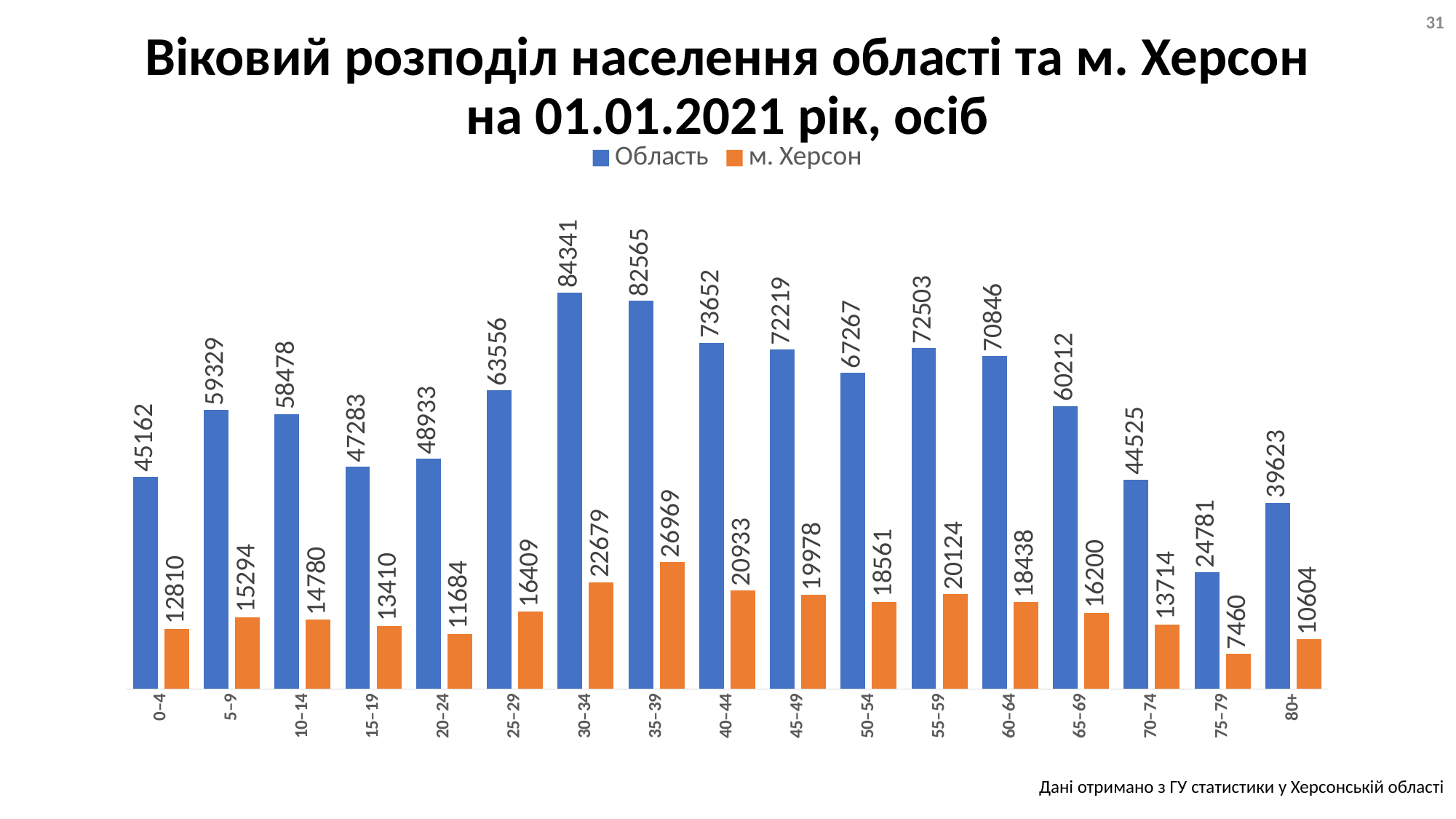
What kind of chart is shown on the slide? Bar chart What is the value for the Область series in the 30–34 age group? 84341 What is the value for м. Херсон in the 20–24 age group? 11684 What is the difference between the Область and м. Херсон values in the 30–34 age group? 61662 How many age groups are shown on the x axis? 17 What is the value for м. Херсон in the 80+ age group? 10604 How many series does the legend list? 2 Which age group has the highest value for the Область series? 30–34 Which is larger for м. Херсон: the 30–34 age group or the 35–39 age group? 35–39 Which age group has the lowest value for м. Херсон? 75–79 Which age group has the highest value for м. Херсон? 35–39 Which age group has the lowest value for the Область series? 75–79